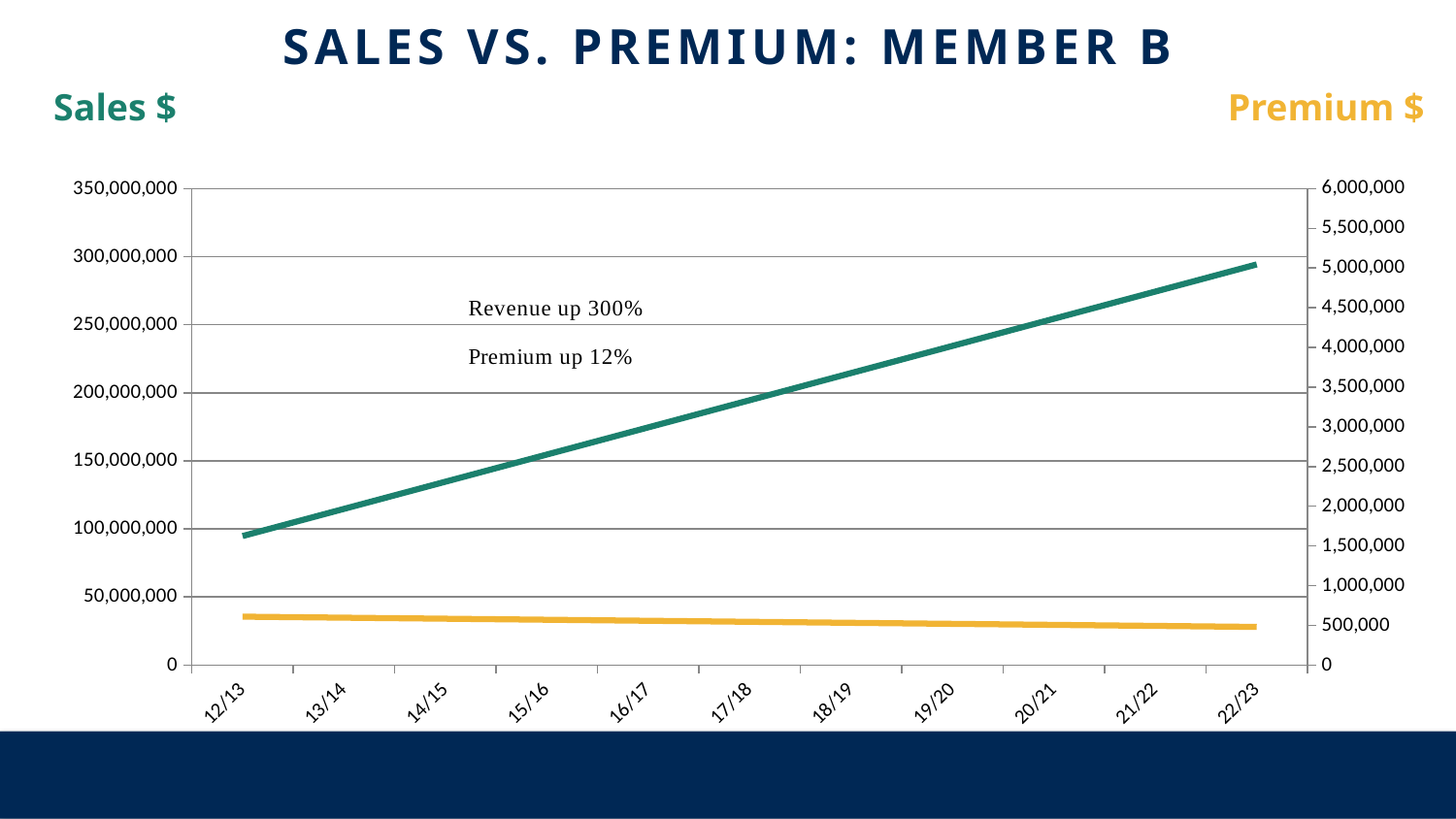
Is the Sales $ value for 12/13 greater or less than 150,000,000? less How many data series are plotted on the chart? 2 Which is larger, the Sales $ value for 22/23 or for 12/13? 22/23 Is the Sales $ value for 22/23 greater or less than 250,000,000? greater What percentage increase in revenue does the annotation on the chart state? 300% Which year has the highest Sales $ value? 22/23 What kind of chart is shown on the slide? line chart Does the Sales $ line rise or fall from 12/13 to 22/23? rise Is the Sales $ value for 19/20 greater or less than 250,000,000? less Which year has the lowest Sales $ value? 12/13 How many fiscal-year points are plotted along the x axis? 11